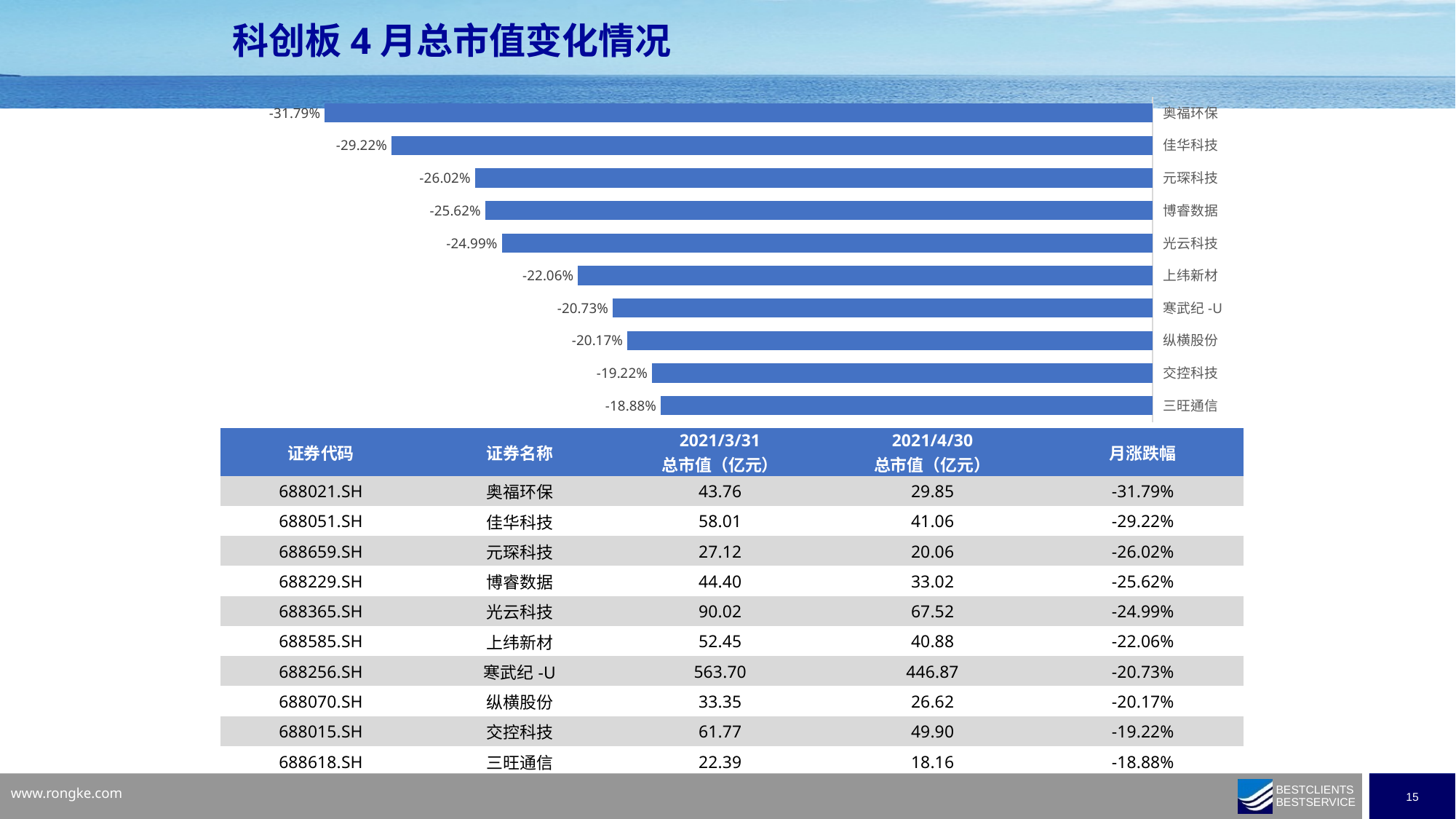
Which category in the bar chart has the lowest (most negative) value? 奥福环保 What is the difference between the values for 奥福环保 and 元琛科技 in the bar chart? 5.77 percentage points What is the value shown for 光云科技 in the bar chart? -24.99% Which category in the bar chart has the highest (least negative) value? 三旺通信 Which has the larger (less negative) value in the bar chart, 上纬新材 or 博睿数据? 上纬新材 What is the value shown for 三旺通信 in the bar chart? -18.88% Which has the larger (less negative) value in the bar chart, 交控科技 or 纵横股份? 交控科技 What kind of chart is shown on the slide? Bar chart How many categories are shown in the bar chart? 10 What is the value shown for 寒武纪 -U in the bar chart? -20.73% What is the difference between the values for 佳华科技 and 三旺通信 in the bar chart? 10.34 percentage points What is the value shown for 奥福环保 in the bar chart? -31.79%